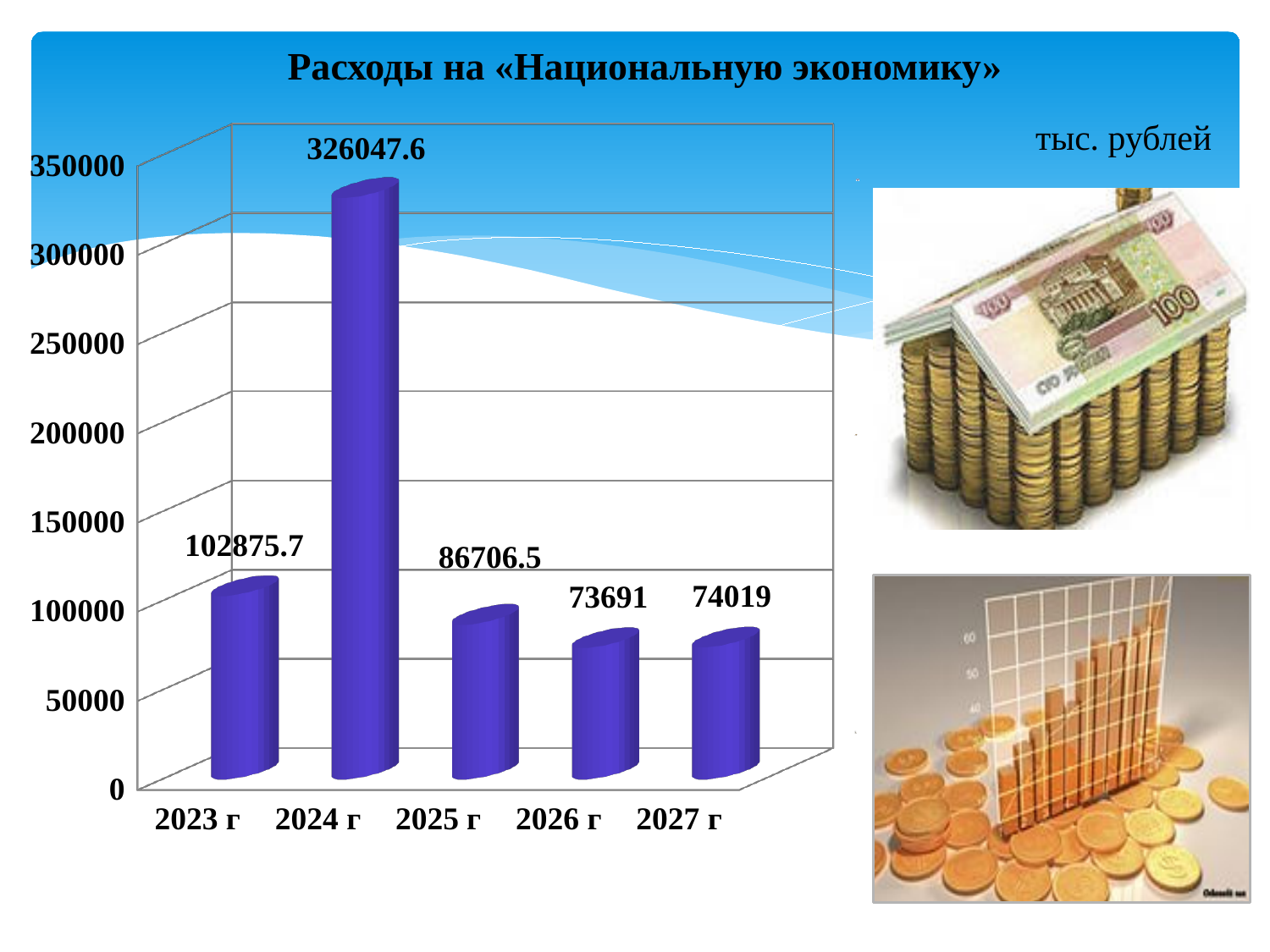
Which is larger, the value for 2025 г or the value for 2026 г? 2025 г What is the value for 2023 г? 102875.7 Is the value for 2024 г greater or less than 300000? greater What unit is indicated for the chart values? тыс. рублей Which year has the highest value? 2024 г What is the difference between the values for 2027 г and 2026 г? 328 What is the value for 2024 г in the chart «Расходы на «Национальную экономику»»? 326047.6 What kind of chart is shown on the slide? bar chart Which year has the lowest value? 2026 г What is the difference between the values for 2024 г and 2023 г? 223171.9 How many years are shown on the x axis? 5 What is the value for 2027 г? 74019